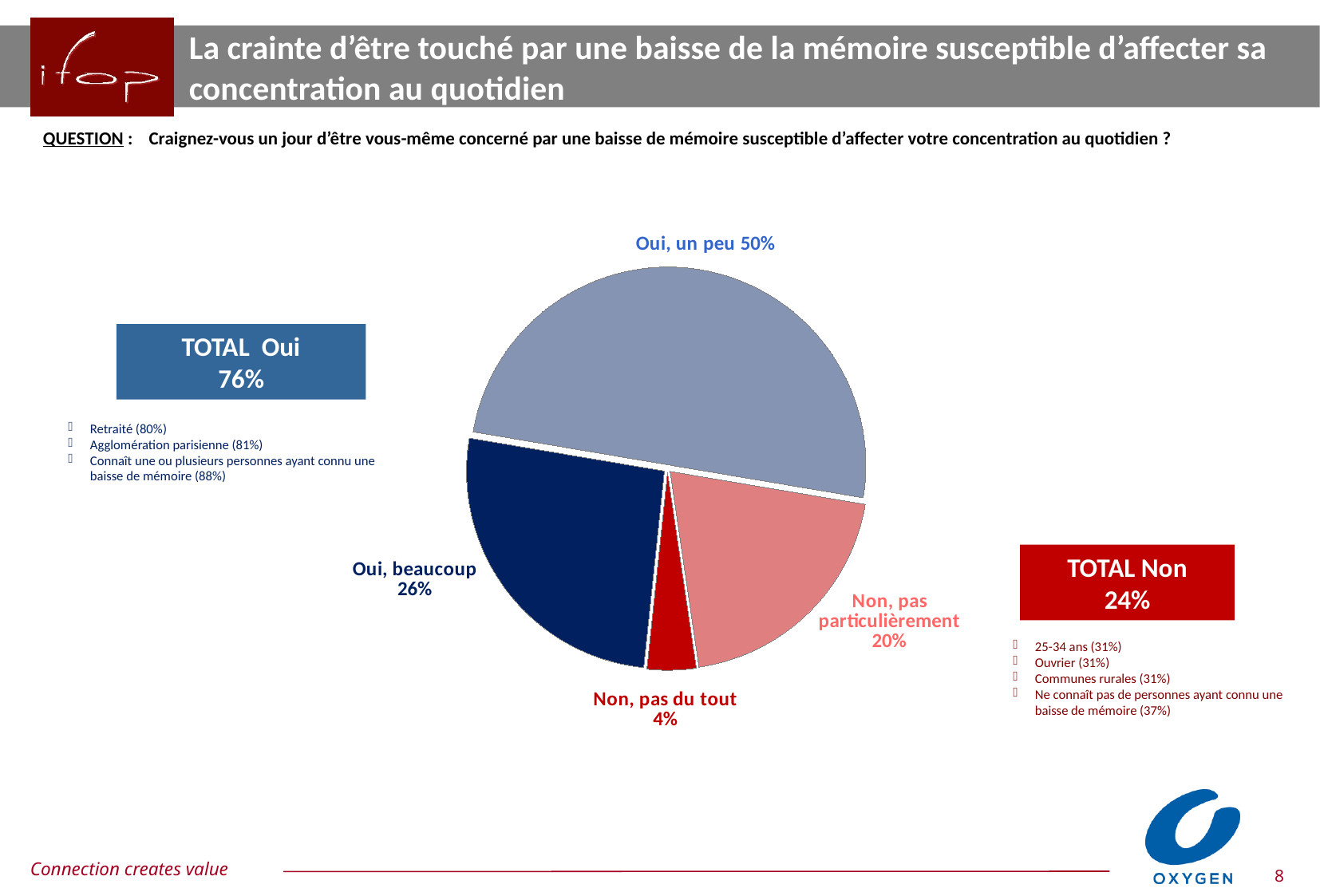
What percentage of respondents answered "Oui, beaucoup"? 26% How many slices does the pie chart have? 4 What percentage of respondents answered "Non, pas du tout"? 4% Which response has the largest share of the pie? Oui, un peu Which response has the smallest share of the pie? Non, pas du tout What percentage of respondents answered "Oui, un peu"? 50% What is the value shown in the "TOTAL Non" box? 24% Which is larger, the share for "Oui, beaucoup" or the share for "Non, pas particulièrement"? Oui, beaucoup What percentage of respondents answered "Non, pas particulièrement"? 20% What kind of chart is shown on the slide? Pie chart What is the value shown in the "TOTAL Oui" box? 76% What is the difference in percentage points between "Oui, un peu" and "Oui, beaucoup"? 24